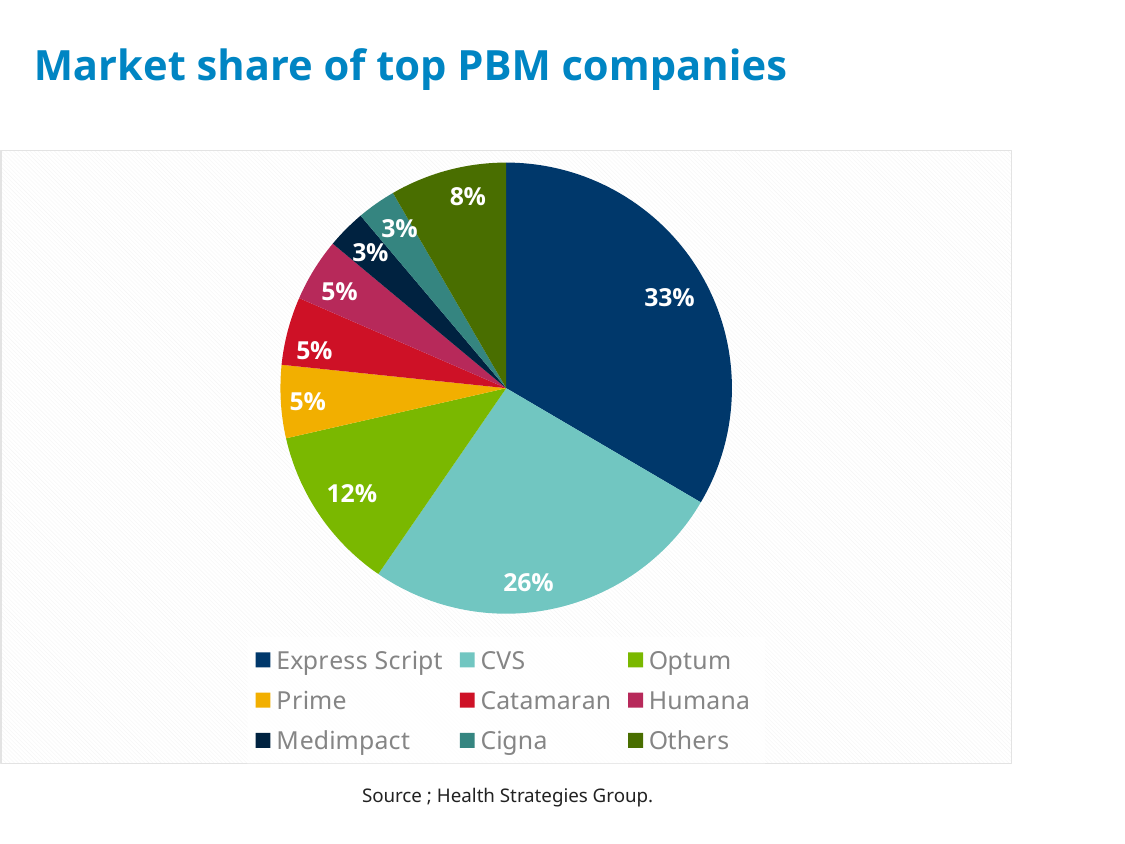
What is the difference in market share between CVS and Optum? 14% What is the difference in market share between Express Script and CVS? 7% What type of chart is shown on the slide? Pie chart How many categories does the legend list? 9 What share of the pie is labelled Others? 8% What is the market share of Cigna? 3% What is the market share of Express Script? 33% What is the market share of Optum? 12% Which company has the largest market share? Express Script What is the title of the chart? Market share of top PBM companies What is the market share of CVS? 26% Which has a larger market share, Optum or Prime? Optum